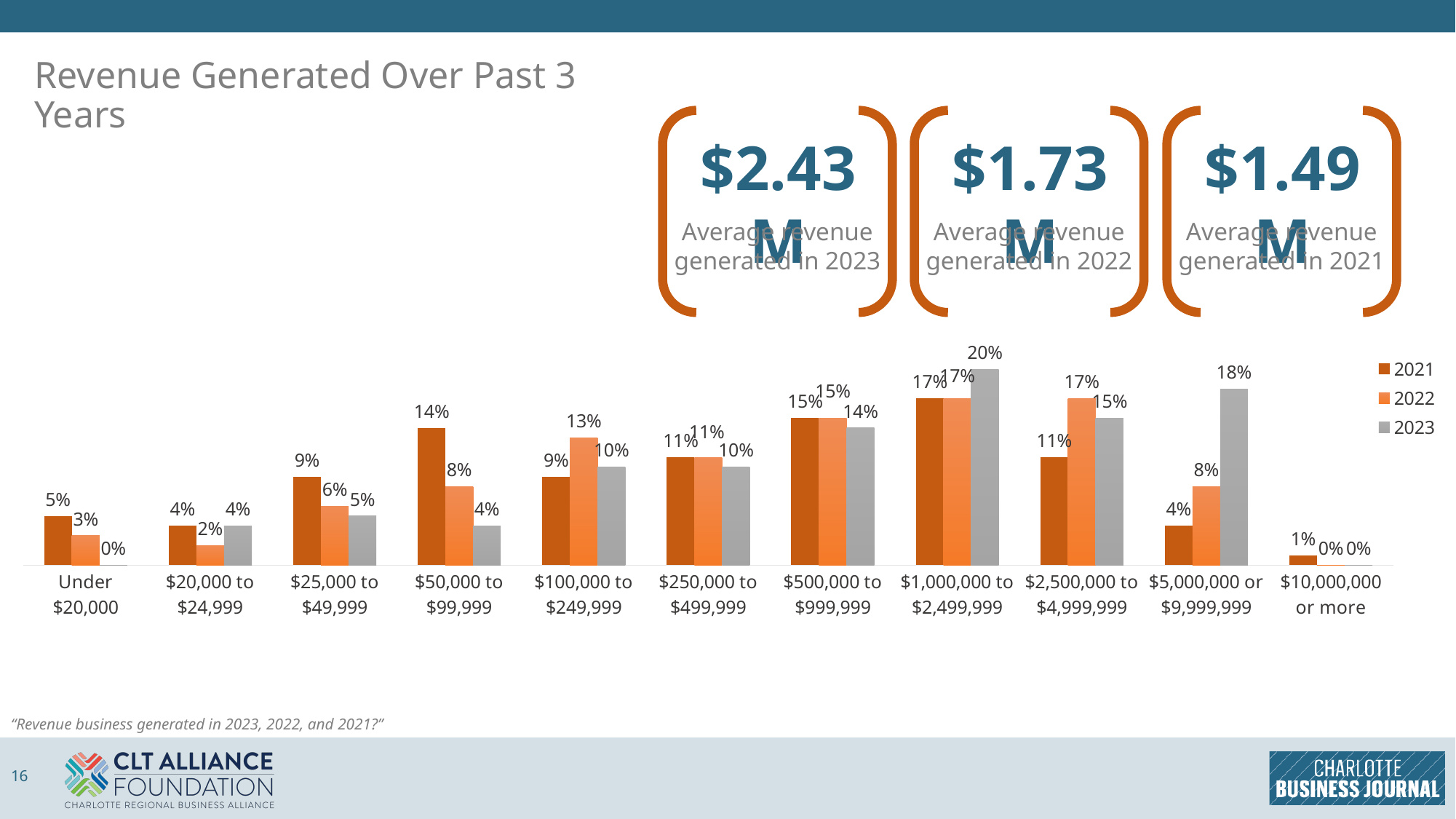
Which category has the lowest 2021 value? $10,000,000 or more What kind of chart is shown on the slide? bar chart How many series does the legend list? 3 Which series is shown in gray in the legend? 2023 What is the 2022 value for the $5,000,000 or $9,999,999 category? 8% How many revenue categories are shown on the x axis? 11 What is the difference between the 2023 and 2021 values for the $5,000,000 or $9,999,999 category? 14% For the $50,000 to $99,999 category, which is larger: the 2021 value or the 2023 value? 2021 What is the 2021 value for the $50,000 to $99,999 category? 14% What is the 2023 value for the $1,000,000 to $2,499,999 category? 20% Which category has the highest 2023 value? $1,000,000 to $2,499,999 What is the average revenue generated in 2023 shown on the slide? $2.43M